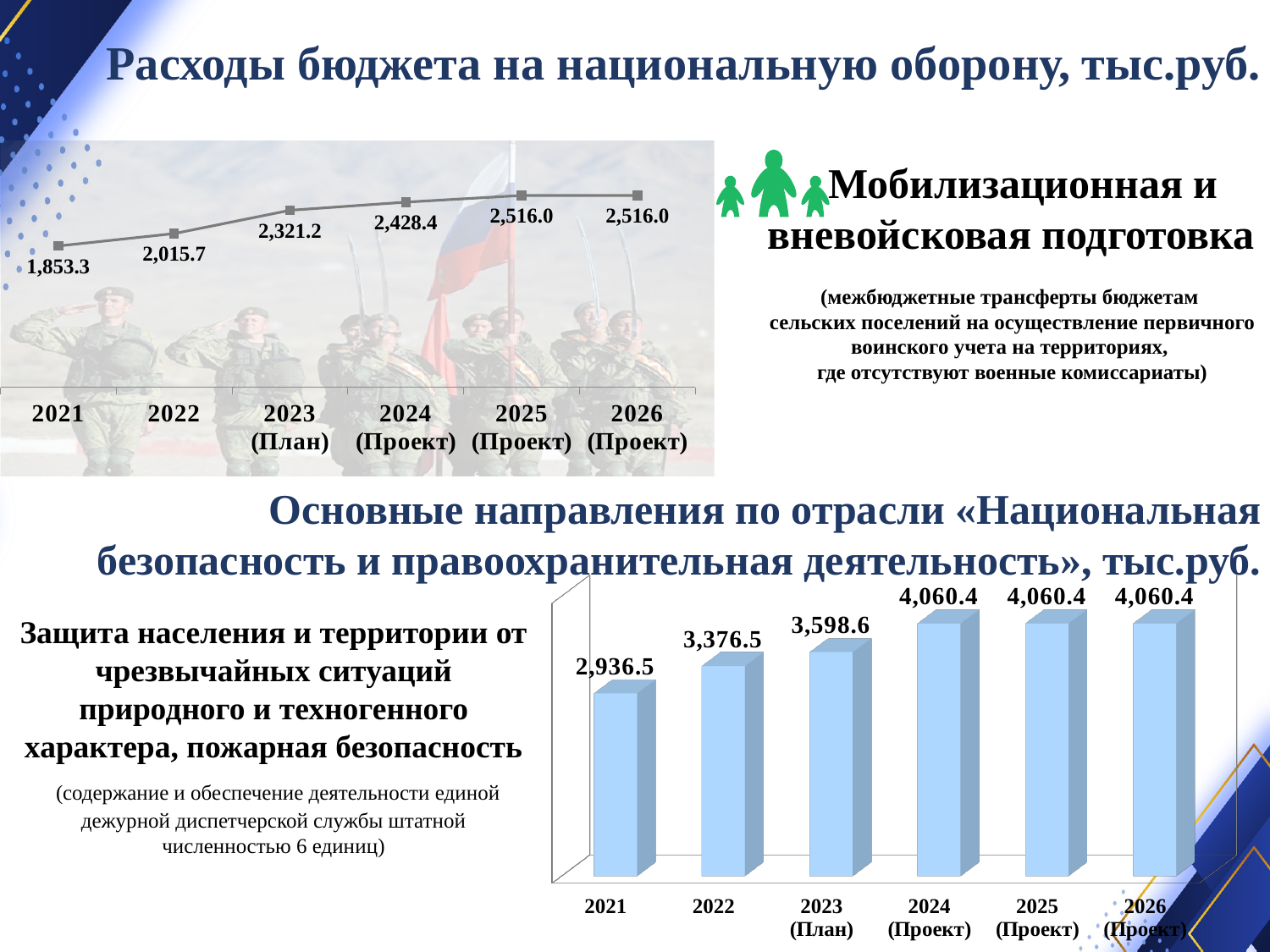
How many data points are plotted in the top-left line chart on national defence expenditures? 6 In the top-left line chart on national defence expenditures, what is the value for 2021? 1,853.3 In the bottom-right bar chart on national security and law enforcement, what is the value for 2021? 2,936.5 In the top-left line chart on national defence expenditures, do the values rise or fall from 2021 to 2024? rise In the bottom-right bar chart on national security and law enforcement, what is the value for 2024 (Проект)? 4,060.4 In the bottom-right bar chart on national security and law enforcement, what is the value for 2023 (План)? 3,598.6 In the top-left line chart on national defence expenditures, what is the difference between the 2022 and 2021 values? 162.4 In the top-left line chart on national defence expenditures, what is the value for 2025 (Проект)? 2,516.0 What type of chart is the bottom-right chart on national security and law enforcement? bar chart In the top-left line chart on national defence expenditures, which year has the lowest value? 2021 In the bottom-right bar chart on national security and law enforcement, what is the difference between the 2022 and 2021 values? 440.0 In the top-left line chart on national defence expenditures, what is the value for 2023 (План)? 2,321.2